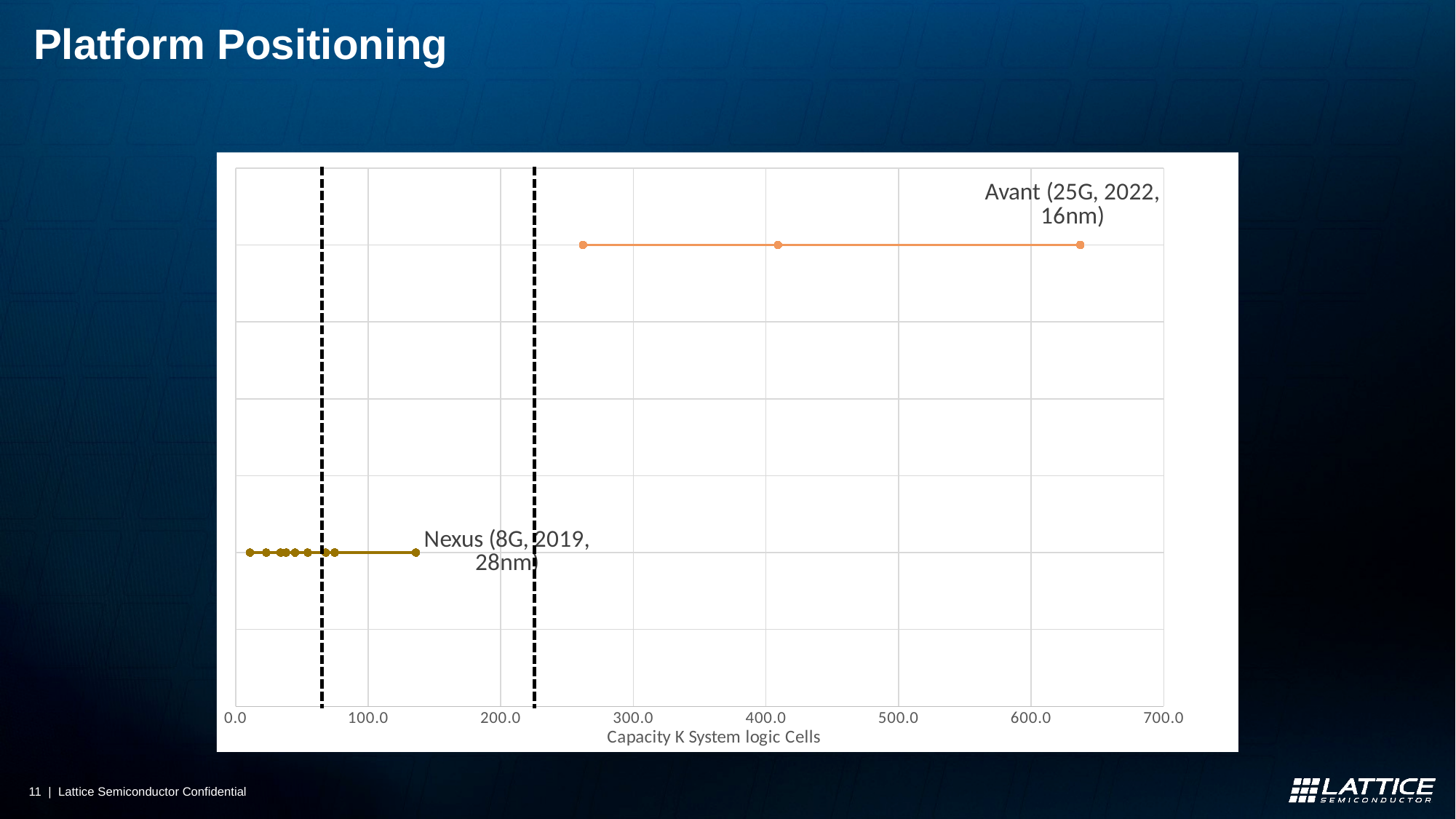
What kind of chart is shown on the slide? Scatter chart Is the rightmost Nexus point greater or less than 200.0 on the x axis? less What is the maximum value shown on the x axis? 700.0 How many series (platforms) are plotted on the chart? 2 Is the rightmost Avant point greater or less than 600.0 on the x axis? greater Which series reaches the highest capacity on the x axis, Nexus or Avant? Avant (25G, 2022, 16nm) How many data points are plotted for the Avant (25G, 2022, 16nm) series? 3 Is the rightmost Nexus point greater or less than 100.0 on the x axis? greater Which series has the lowest capacity point on the x axis? Nexus (8G, 2019, 28nm) What is the title of the x axis? Capacity K System logic Cells